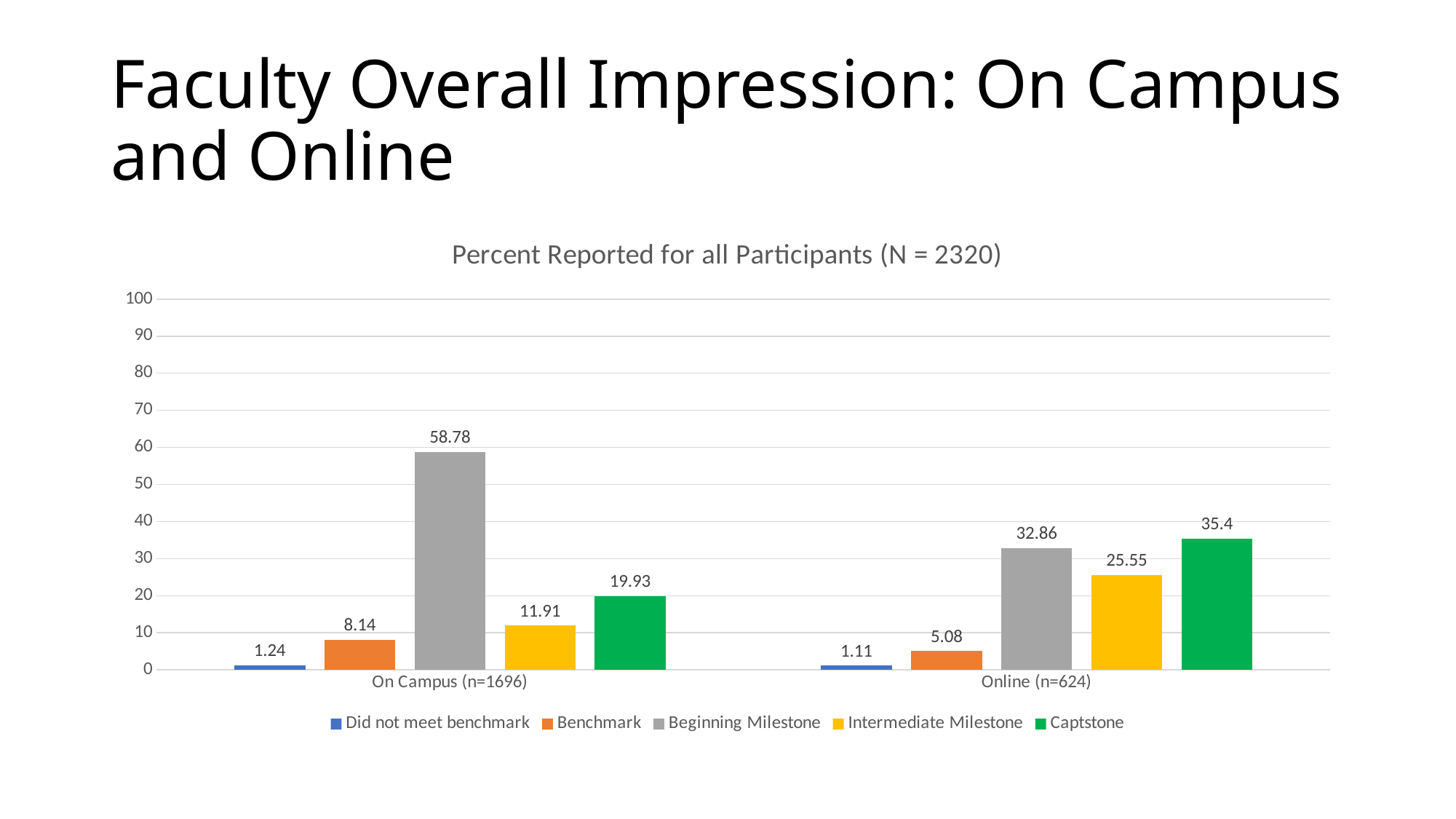
What is the value for Benchmark in the Online (n=624) group? 5.08 Which is larger: Intermediate Milestone for On Campus (n=1696) or Intermediate Milestone for Online (n=624)? Online (n=624) Which series has the lowest value in the Online (n=624) group? Did not meet benchmark How many groups are shown on the x axis? 2 What is the value for Beginning Milestone in the On Campus (n=1696) group? 58.78 Is the value for Captstone in the On Campus (n=1696) group greater or less than 30? less How many series does the legend list? 5 Which series has the highest value in the On Campus (n=1696) group? Beginning Milestone What is the difference between the Beginning Milestone values for On Campus (n=1696) and Online (n=624)? 25.92 What is the value for Captstone in the Online (n=624) group? 35.4 What kind of chart is shown on the slide? Bar chart What is the title of the chart? Percent Reported for all Participants (N = 2320)